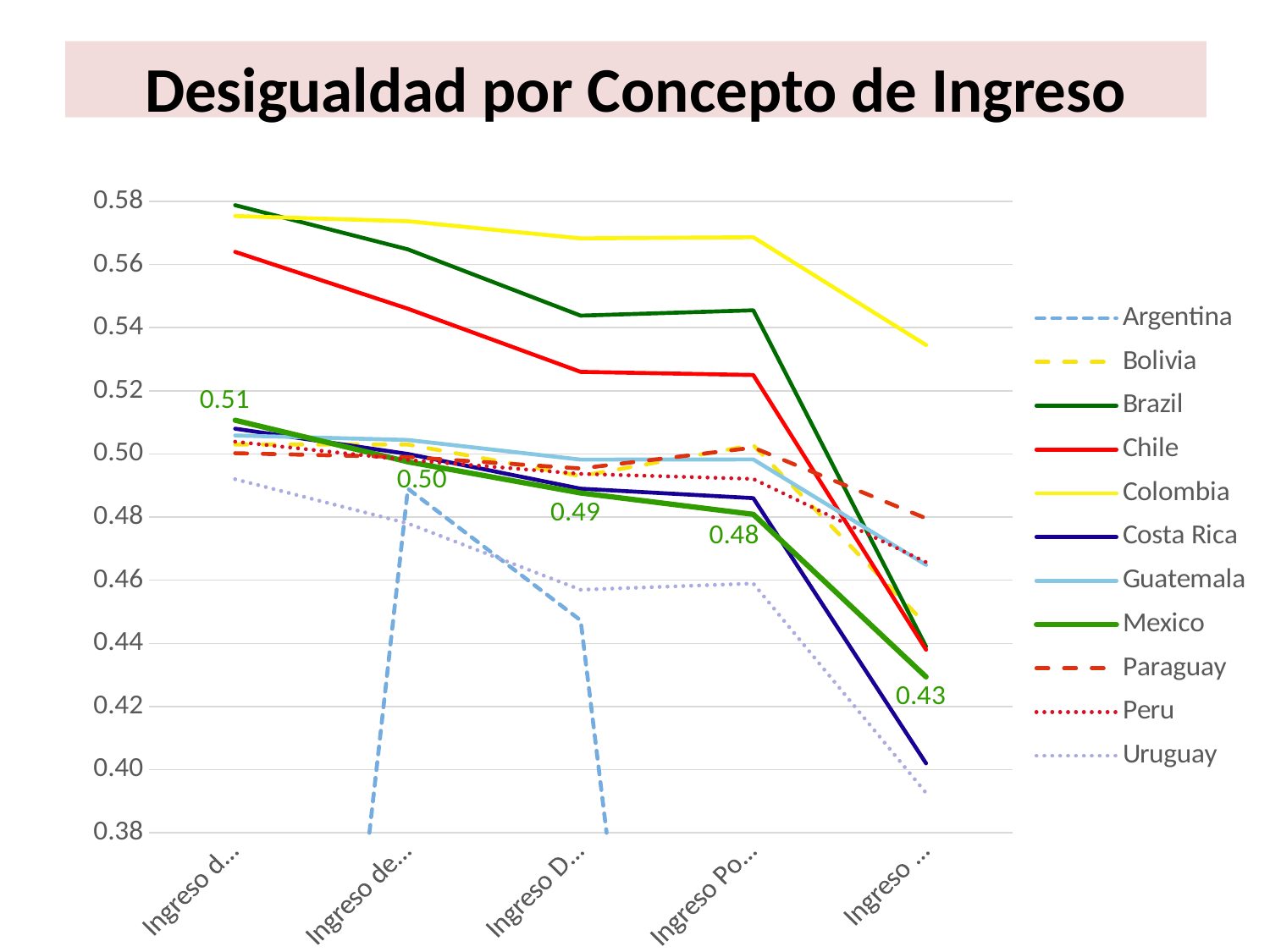
Which series has the lowest value at the last x-axis category? Uruguay How many categories are shown along the x axis? 5 Do the values for Mexico rise or fall from the first category to the last? fall Is the value for Colombia at the first x-axis category greater or less than 0.56? greater What is the labelled value for Mexico at the first x-axis category? 0.51 What is the labelled value for Mexico at the last x-axis category? 0.43 What is the difference between Mexico's value at the first category and its value at the last category? 0.08 How many series does the legend list? 11 What kind of chart is shown on the slide? line chart Which series has the highest value at the last x-axis category? Colombia What is the title of the chart? Desigualdad por Concepto de Ingreso What is the labelled value for Mexico at the third x-axis category? 0.49